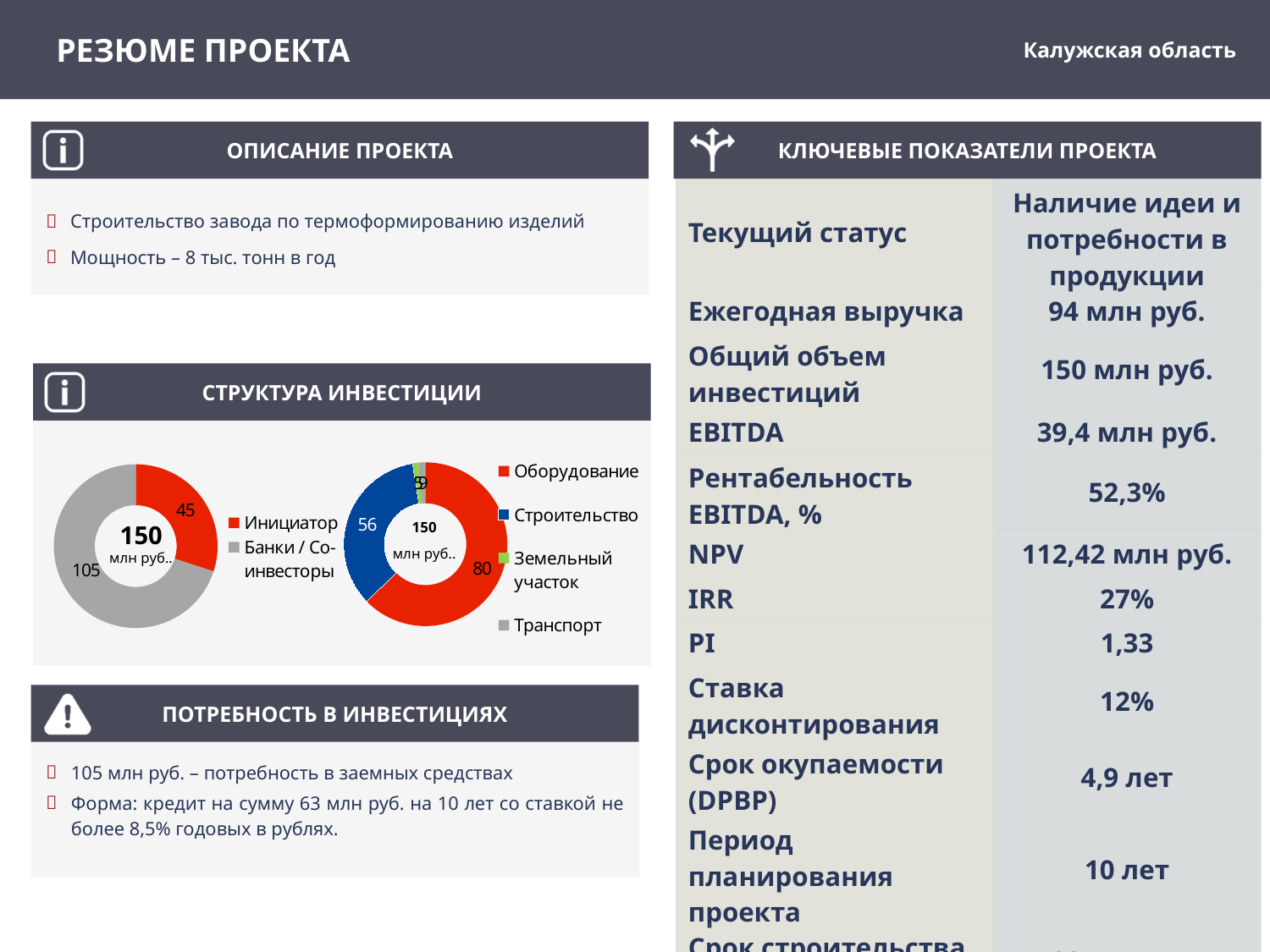
How many categories does the legend of the right donut chart under 'СТРУКТУРА ИНВЕСТИЦИИ' list? 4 In the left donut chart under 'СТРУКТУРА ИНВЕСТИЦИИ', what share of the total does Инициатор represent? 30% In the left donut chart under 'СТРУКТУРА ИНВЕСТИЦИИ', what is the value for Инициатор? 45 In the right donut chart under 'СТРУКТУРА ИНВЕСТИЦИИ', what is the value for Оборудование? 80 In the right donut chart under 'СТРУКТУРА ИНВЕСТИЦИИ', which category has the largest value? Оборудование In the right donut chart under 'СТРУКТУРА ИНВЕСТИЦИИ', what is the difference between Оборудование and Строительство? 24 In the left donut chart under 'СТРУКТУРА ИНВЕСТИЦИИ', what is the value for Банки / Со-инвесторы? 105 In the left donut chart under 'СТРУКТУРА ИНВЕСТИЦИИ', what is the difference between Банки / Со-инвесторы and Инициатор? 60 In the left donut chart under 'СТРУКТУРА ИНВЕСТИЦИИ', what total is shown in the centre of the donut? 150 млн руб. How many categories does the legend of the left donut chart under 'СТРУКТУРА ИНВЕСТИЦИИ' list? 2 In the left donut chart under 'СТРУКТУРА ИНВЕСТИЦИИ', which category has the larger value? Банки / Со-инвесторы In the right donut chart under 'СТРУКТУРА ИНВЕСТИЦИИ', what is the value for Строительство? 56